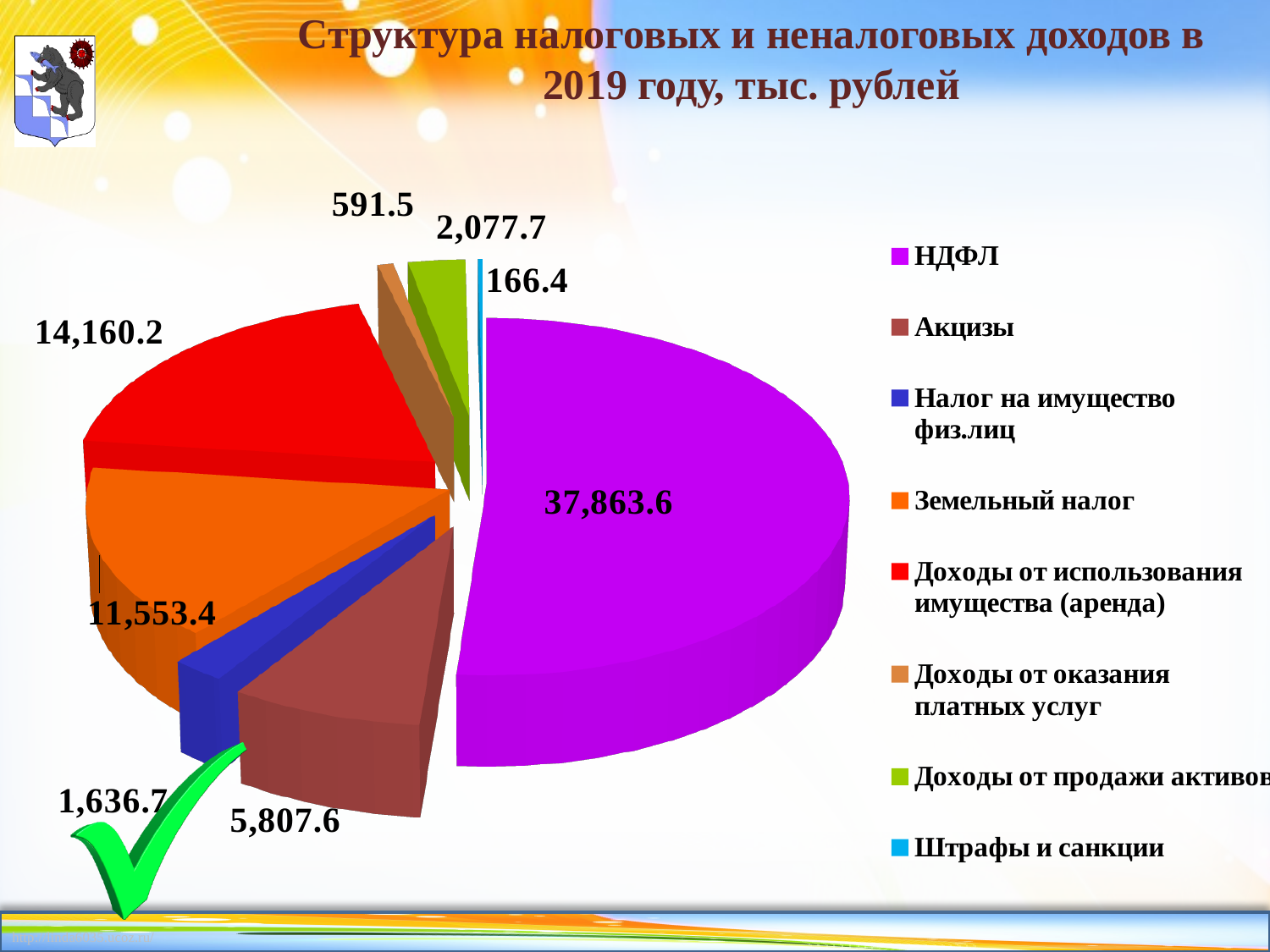
What is the value for Доходы от использования имущества (аренда)? 14,160.2 What is the difference between Доходы от использования имущества (аренда) and Земельный налог? 2,606.8 What is the value for Акцизы? 5,807.6 What is the title of the chart? Структура налоговых и неналоговых доходов в 2019 году, тыс. рублей What is the value for Земельный налог? 11,553.4 How many categories does the pie chart show? 8 What is the value for НДФЛ? 37,863.6 Which is larger: Акцизы or Налог на имущество физ.лиц? Акцизы What is the value for Штрафы и санкции? 166.4 Which category has the smallest value? Штрафы и санкции What kind of chart is shown on the slide? Pie chart Which category has the largest value? НДФЛ